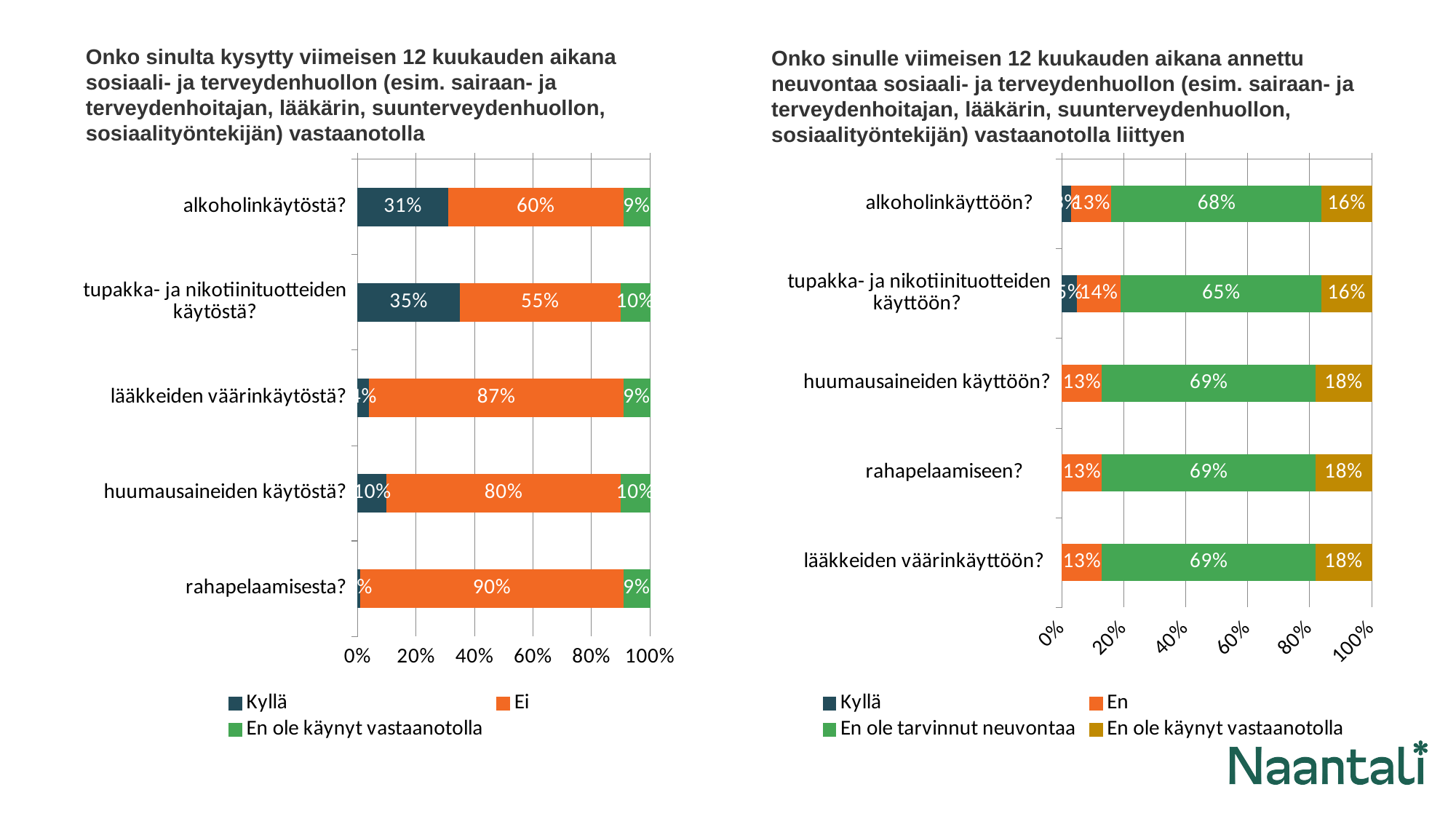
In the left chart (Onko sinulta kysytty...), how many series does the legend list? 3 In the left chart (Onko sinulta kysytty...), what percentage answered Ei for lääkkeiden väärinkäytöstä? 87% In the left chart (Onko sinulta kysytty...), which category has the highest Kyllä share? tupakka- ja nikotiinituotteiden käytöstä? In the left chart (Onko sinulta kysytty...), what is the difference between the Ei share for rahapelaamisesta and the Ei share for alkoholinkäytöstä? 30% In the right chart (Onko sinulle ... annettu neuvontaa...), what percentage answered En ole käynyt vastaanotolla for rahapelaamiseen? 18% In the left chart (Onko sinulta kysytty...), how many categories are shown? 5 In the right chart (Onko sinulle ... annettu neuvontaa...), which category has the lowest En ole tarvinnut neuvontaa share? tupakka- ja nikotiinituotteiden käyttöön? In the right chart (Onko sinulle ... annettu neuvontaa...), how many series does the legend list? 4 In the left chart (Onko sinulta kysytty...), which category has the highest Ei share? rahapelaamisesta? In the left chart (Onko sinulta kysytty...), what percentage answered Kyllä for alkoholinkäytöstä? 31% What type of chart is used on the right side of the slide? Stacked bar chart In the right chart (Onko sinulle ... annettu neuvontaa...), what percentage answered En ole tarvinnut neuvontaa for alkoholinkäyttöön? 68%